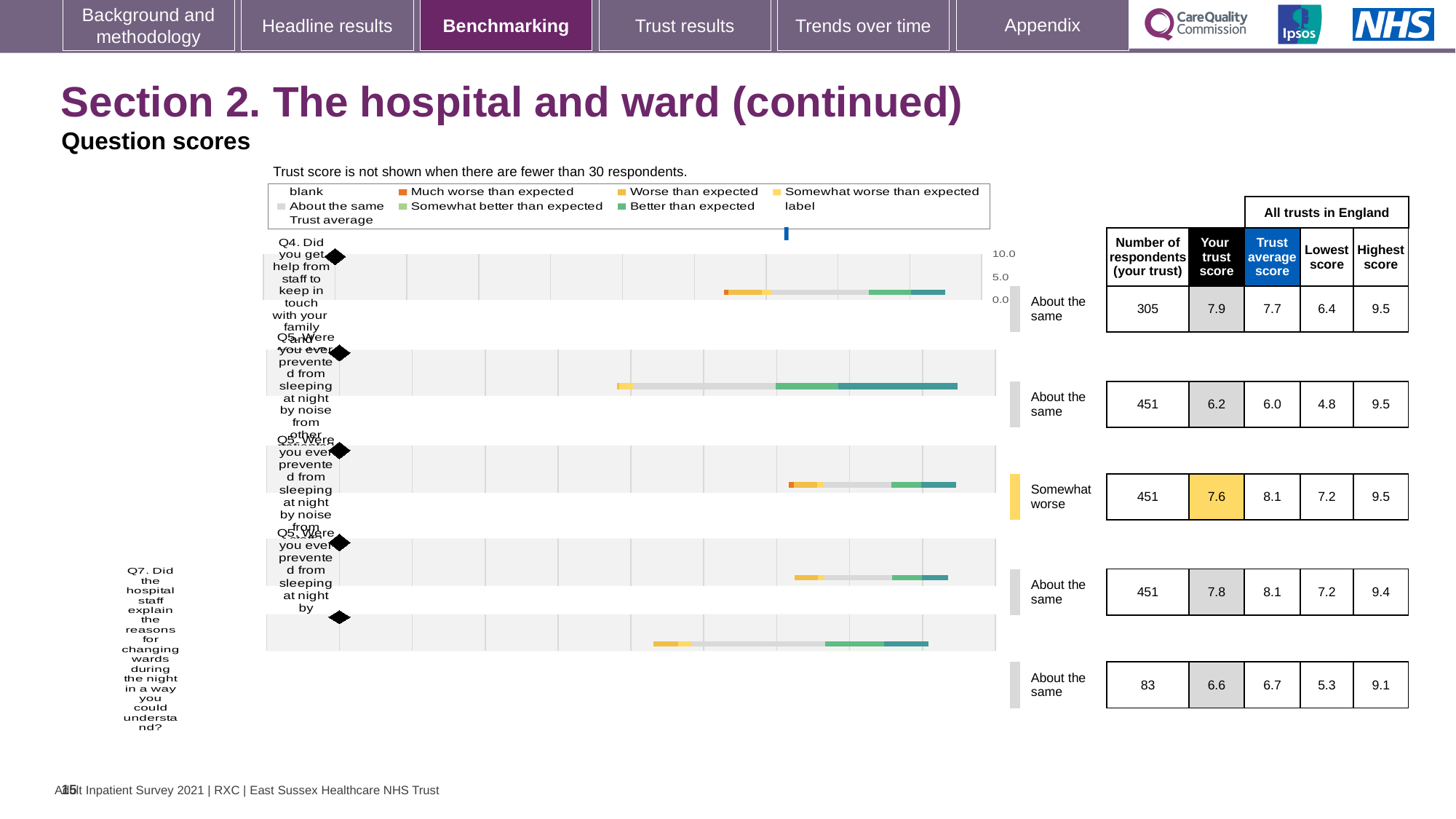
What kind of chart is used to show the question scores on this slide? Bar chart In the legend, which colour represents 'Much worse than expected'? Orange For Q4, what is the difference between the trust score (7.9) and the trust average score (7.7)? 0.2 For Q7, which is larger: the trust score or the trust average score? Trust average score What is the trust score for Q4 (help from staff to keep in touch with family and friends)? 7.9 What is the number of respondents for Q4 (help from staff to keep in touch with family and friends)? 305 Which question row has the fewest respondents? Q7 What is the trust score for the row rated 'Somewhat worse' than expected? 7.6 In the legend, which colour represents 'Better than expected'? Teal What is the highest score across all trusts in England for Q7 (explaining reasons for changing wards during the night)? 9.1 How many question rows (bars) are plotted in the benchmarking chart? 5 Which question row has the highest 'Your trust score'? Q4